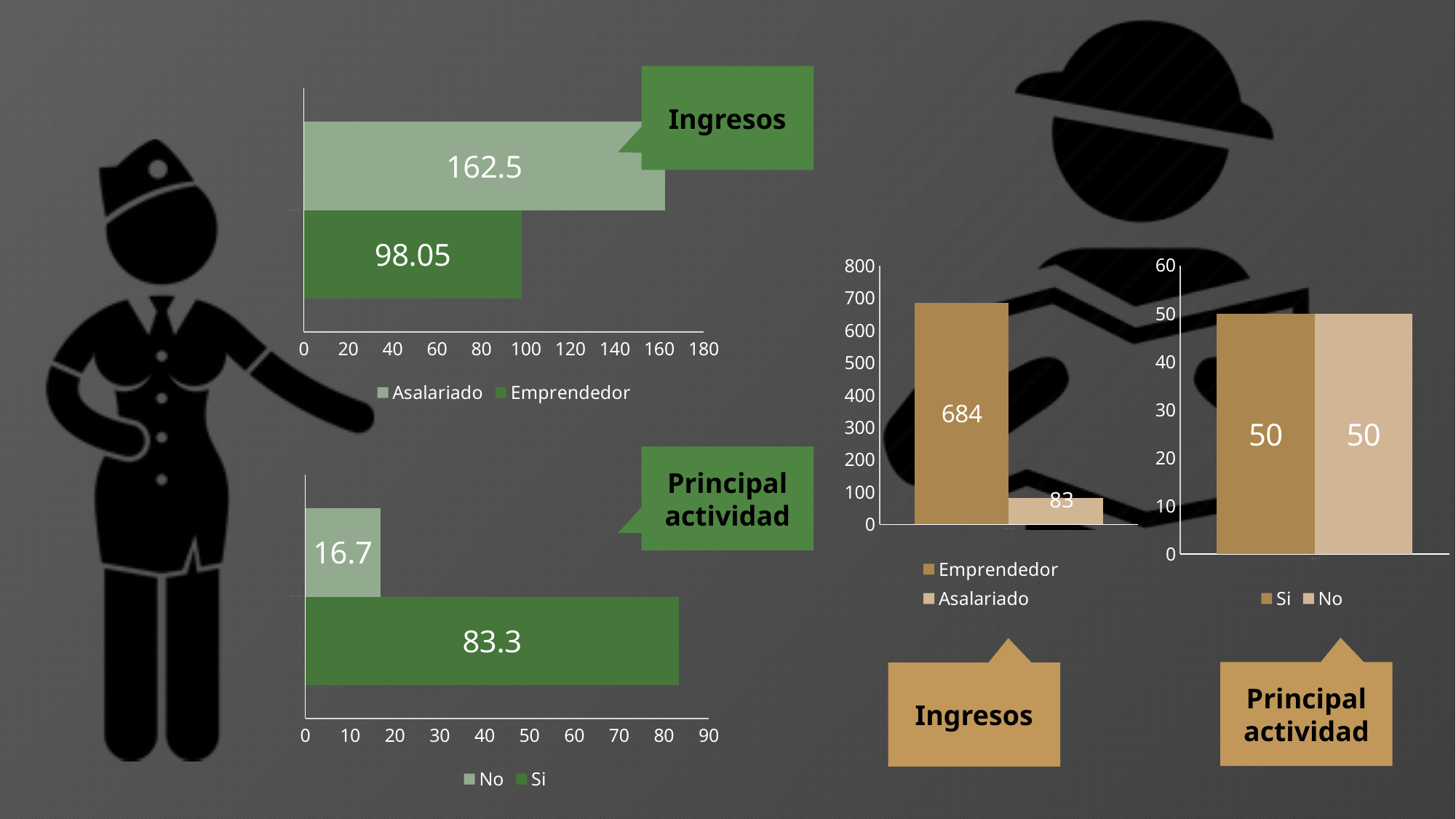
In the green Ingresos bar chart on the left, what is the value for Emprendedor? 98.05 In the brown Ingresos bar chart on the right, what is the value for Emprendedor? 684 In the green Ingresos bar chart on the left, what is the value for Asalariado? 162.5 In the green Principal actividad bar chart on the left, which is larger, Si or No? Si In the brown Ingresos bar chart on the right, what is the difference between the Emprendedor and Asalariado values? 601 In the brown Ingresos bar chart on the right, what is the value for Asalariado? 83 In the brown Principal actividad bar chart on the right, what is the value for Si? 50 In the green Ingresos bar chart on the left, what is the difference between the Asalariado and Emprendedor values? 64.45 How many series does the legend of the brown Principal actividad chart on the right list? 2 In the green Principal actividad bar chart on the left, what is the value for Si? 83.3 In the green Ingresos bar chart on the left, which series has the higher value? Asalariado In the green Principal actividad bar chart on the left, what is the value for No? 16.7